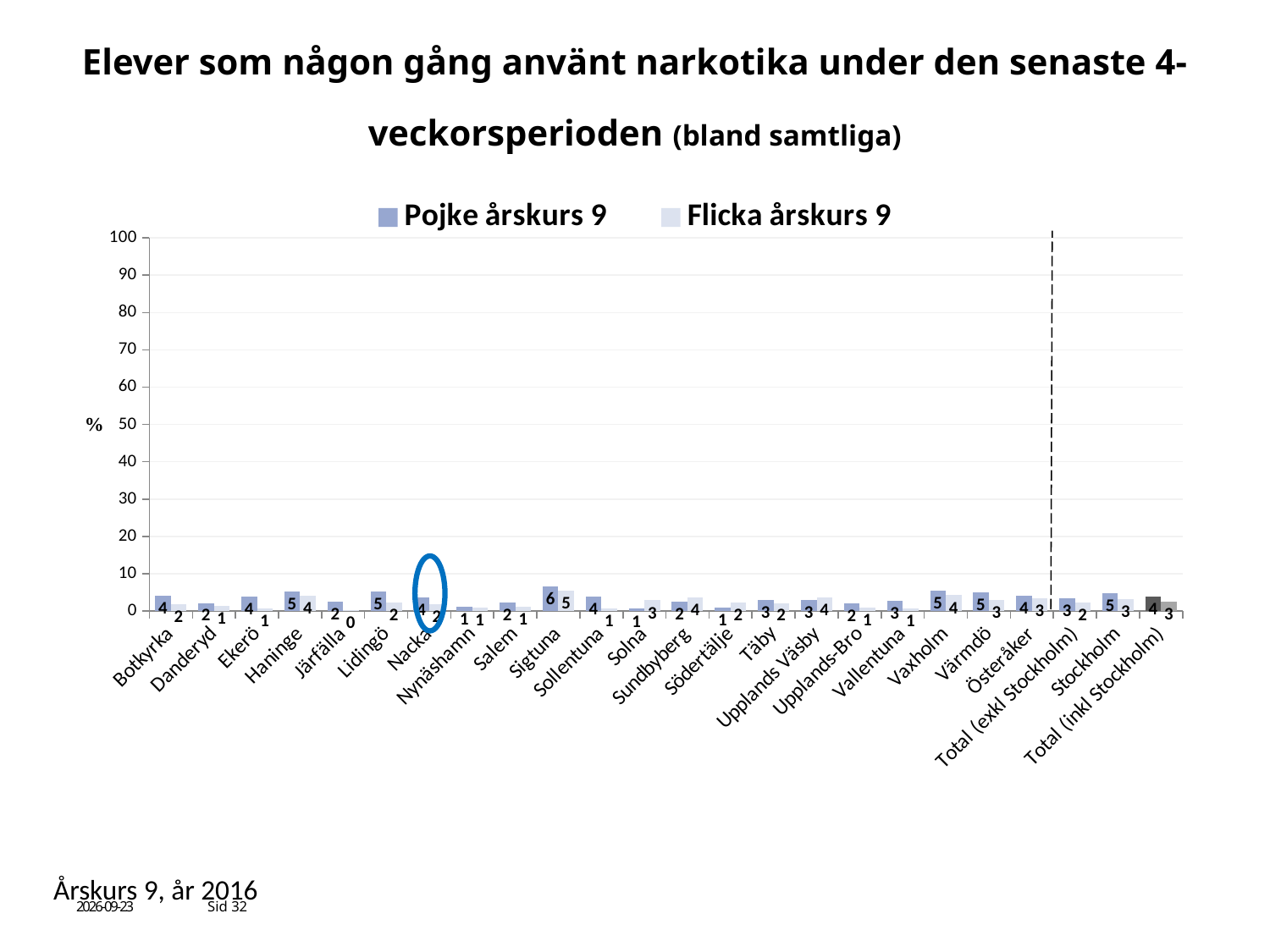
Which municipality has the highest value for Pojke årskurs 9? Sigtuna Is the value for Pojke årskurs 9 in Sigtuna greater or less than 10? less What is the difference between the Pojke årskurs 9 and Flicka årskurs 9 values in Sollentuna? 3 Which is larger in Solna: the value for Pojke årskurs 9 or Flicka årskurs 9? Flicka årskurs 9 What is the value for Pojke årskurs 9 in Stockholm? 5 What is the value for Flicka årskurs 9 in Total (inkl Stockholm)? 3 What is the value for Flicka årskurs 9 in Järfälla? 0 Which category has the lowest value for Flicka årskurs 9? Järfälla What is the value for Pojke årskurs 9 in Sigtuna? 6 How many categories are shown on the x axis? 24 What kind of chart is shown on the slide? bar chart How many series does the legend list? 2